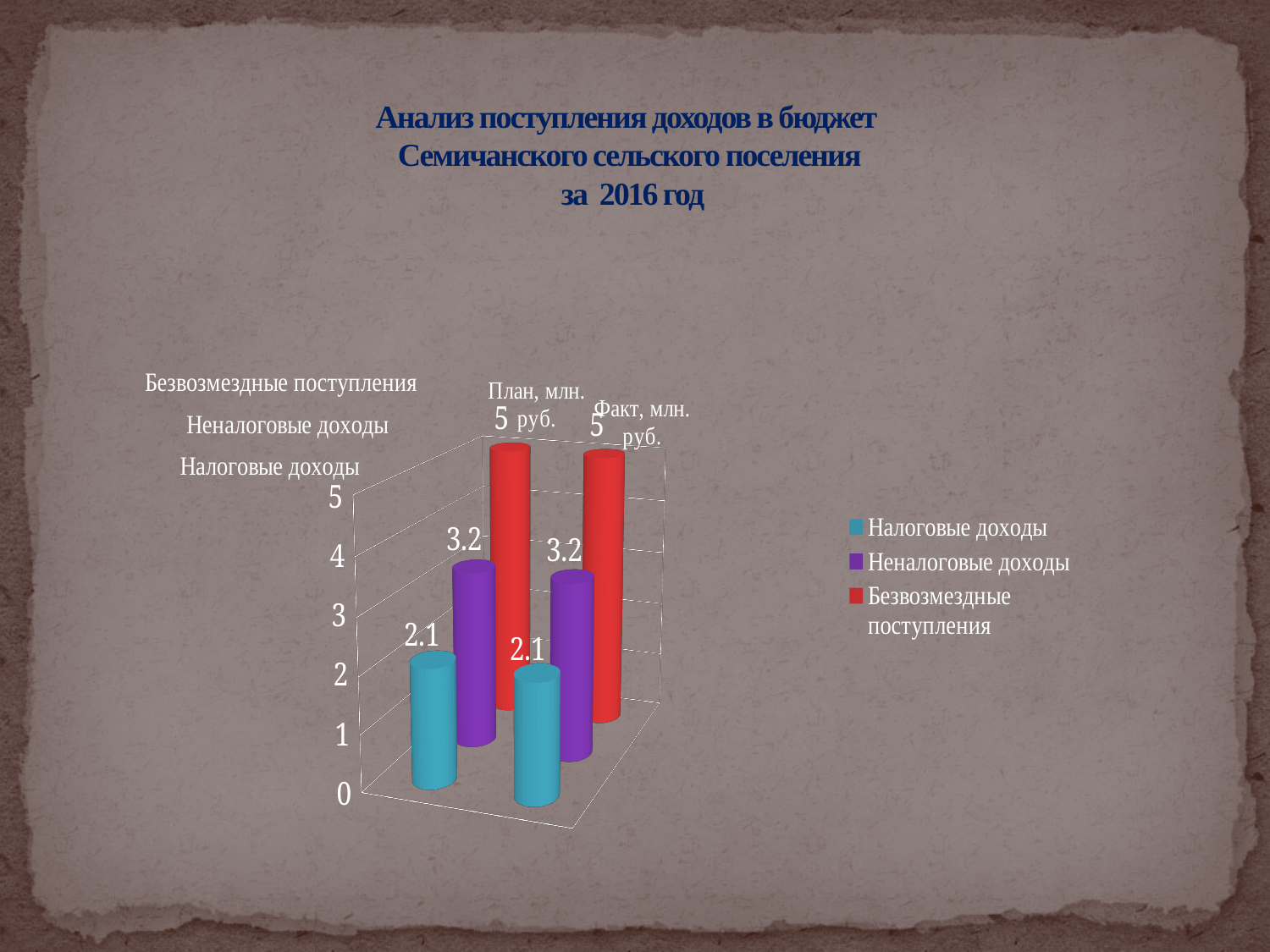
What is the value of Неналоговые доходы for Факт, млн. руб.? 3.2 Which series has the highest value for План, млн. руб.? Безвозмездные поступления Which is larger for Факт, млн. руб.: Неналоговые доходы or Налоговые доходы? Неналоговые доходы What is the value of Налоговые доходы for План, млн. руб.? 2.1 What colour represents Безвозмездные поступления in the chart? Red How many series does the legend list? 3 What kind of chart is shown on the slide? Bar chart What is the difference between Безвозмездные поступления and Налоговые доходы for План, млн. руб.? 2.9 Which series has the lowest value for Факт, млн. руб.? Налоговые доходы What is the value of Безвозмездные поступления for Факт, млн. руб.? 5 Does the value of Налоговые доходы change between План and Факт? No, it is 2.1 in both How many categories are shown on the x axis? 2